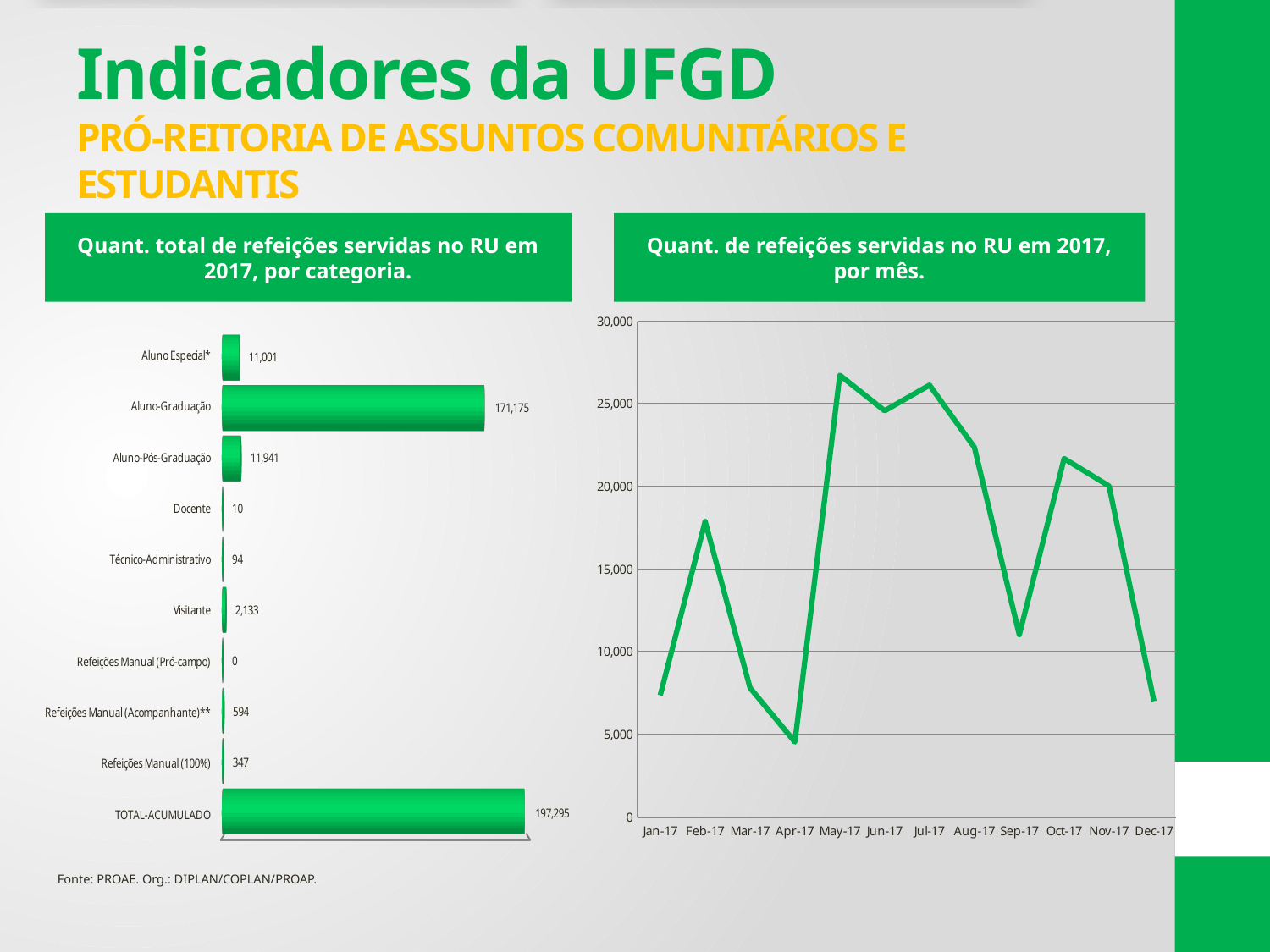
In the chart 'Quant. de refeições servidas no RU em 2017, por mês', which month has the lowest value? Apr-17 In the chart 'Quant. total de refeições servidas no RU em 2017, por categoria', excluding TOTAL-ACUMULADO, which category has the highest value? Aluno-Graduação In the chart 'Quant. total de refeições servidas no RU em 2017, por categoria', what is the value for TOTAL-ACUMULADO? 197,295 In the chart 'Quant. total de refeições servidas no RU em 2017, por categoria', what is the value for Visitante? 2,133 In the chart 'Quant. de refeições servidas no RU em 2017, por mês', which month has the highest value? May-17 What kind of chart is 'Quant. total de refeições servidas no RU em 2017, por categoria'? Bar chart In the chart 'Quant. total de refeições servidas no RU em 2017, por categoria', what is the value for Aluno-Graduação? 171,175 How many months are plotted in the chart 'Quant. de refeições servidas no RU em 2017, por mês'? 12 In the chart 'Quant. de refeições servidas no RU em 2017, por mês', is the value for Feb-17 greater or less than 15,000? greater In the chart 'Quant. total de refeições servidas no RU em 2017, por categoria', which is larger: Refeições Manual (Acompanhante)** or Refeições Manual (100%)? Refeições Manual (Acompanhante)** In the chart 'Quant. total de refeições servidas no RU em 2017, por categoria', what is the difference between Aluno-Pós-Graduação and Aluno Especial*? 940 In the chart 'Quant. total de refeições servidas no RU em 2017, por categoria', which category has the lowest value? Refeições Manual (Pró-campo)